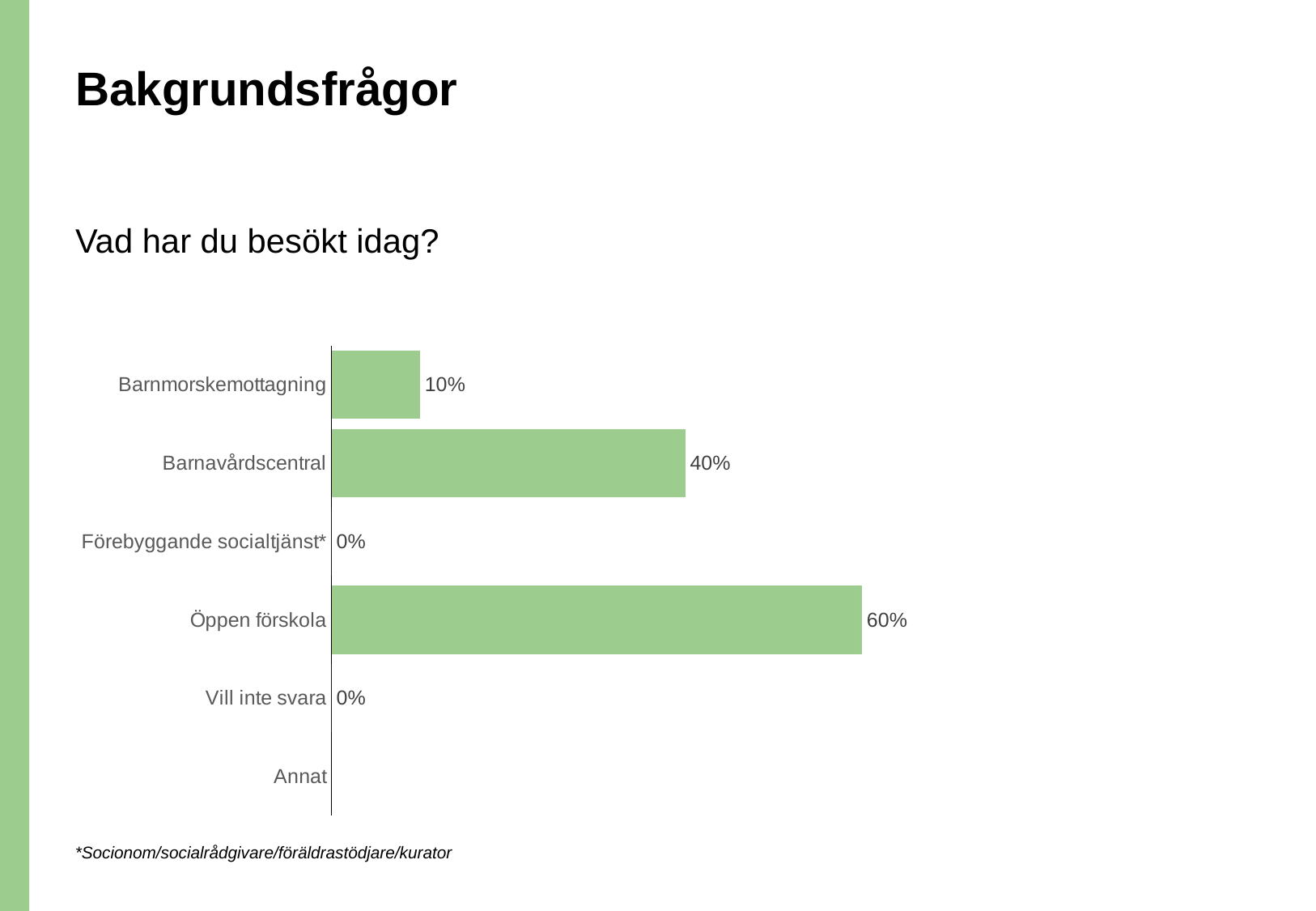
What question is the chart titled with? Vad har du besökt idag? How many categories are listed on the chart's axis? 6 Which category has the highest value? Öppen förskola What is the value for Förebyggande socialtjänst*? 0% What is the value for Barnmorskemottagning? 10% What is the difference between the values for Barnavårdscentral and Barnmorskemottagning? 30% What is the value for Öppen förskola? 60% What kind of chart is shown on the slide? bar chart What is the value for Barnavårdscentral? 40% What is the difference between the values for Öppen förskola and Barnavårdscentral? 20% Which is larger, the value for Barnavårdscentral or the value for Barnmorskemottagning? Barnavårdscentral What is the value for Vill inte svara? 0%